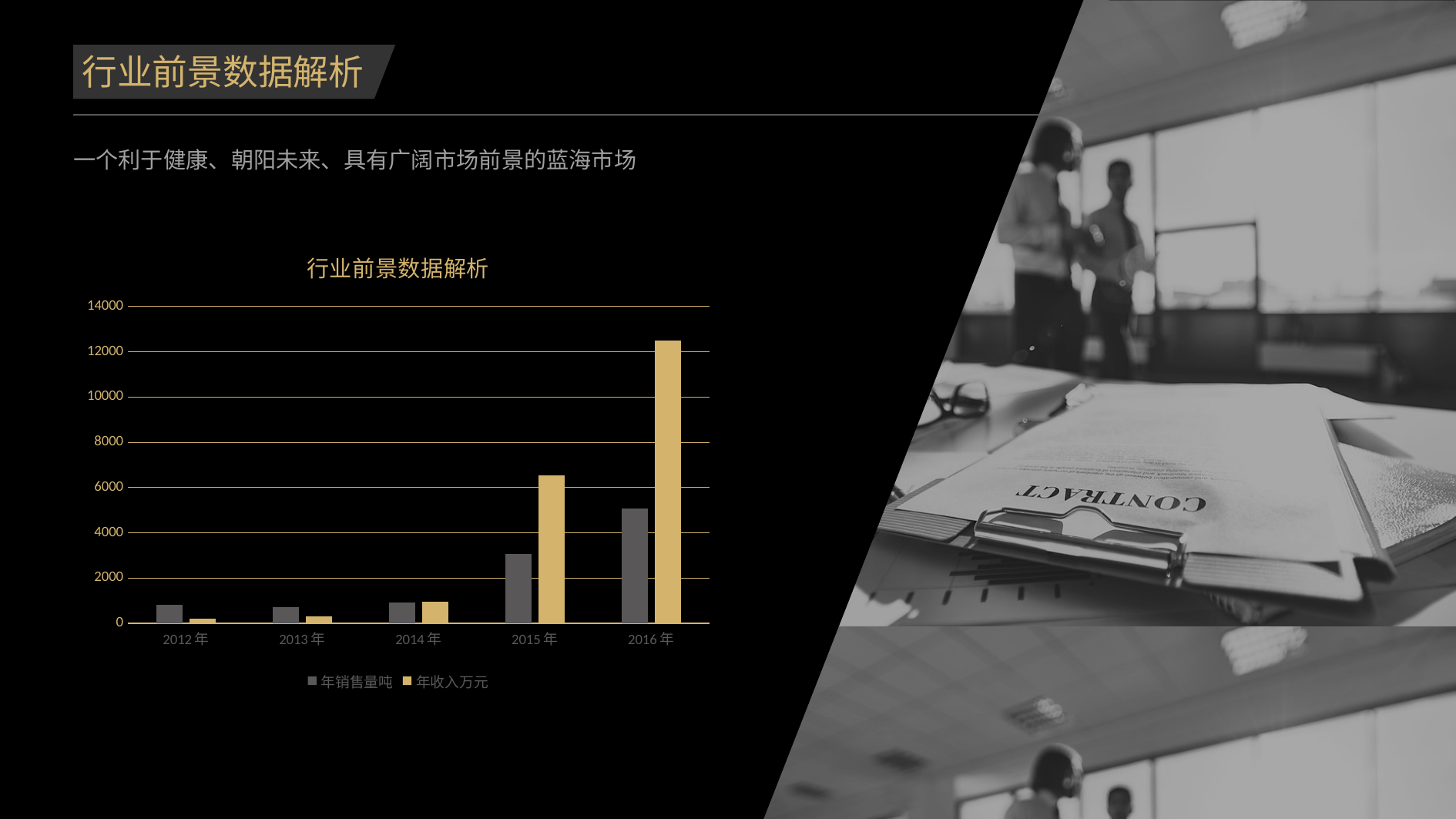
Is the value for 年收入万元 in 2016 年 greater or less than 12000? greater Is the value for 年销售量吨 in 2016 年 greater or less than 4000? greater Does the value for 年收入万元 rise or fall from 2014 年 to 2016 年? rise Is the value for 年收入万元 in 2014 年 greater or less than 2000? less What is the title of the chart? 行业前景数据解析 How many series does the chart legend list? 2 In 2015 年, which is larger: 年销售量吨 or 年收入万元? 年收入万元 What kind of chart is shown on the slide? bar chart How many years are shown on the x axis of the chart? 5 Which year has the highest value for 年收入万元? 2016 年 Which year has the highest value for 年销售量吨? 2016 年